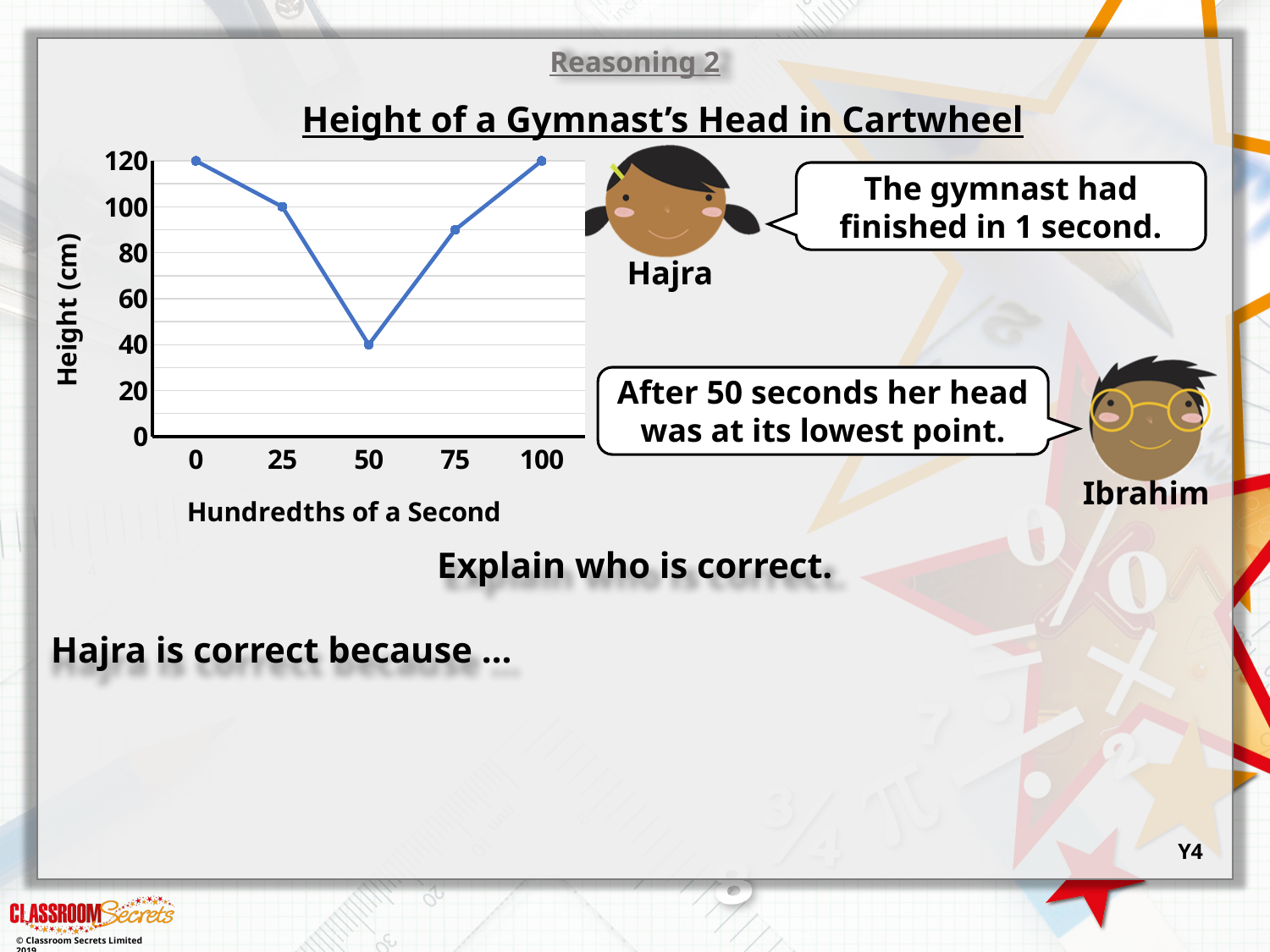
Does the height rise or fall between 0 and 50 hundredths of a second? fall What is the height of the gymnast's head at 0 hundredths of a second? 120 Which time has the greater height: 25 or 75 hundredths of a second? 25 At which time (in hundredths of a second) is the height of the gymnast's head lowest? 50 What is the height of the gymnast's head at 25 hundredths of a second? 100 Is the height at 75 hundredths of a second greater or less than 80? greater What kind of chart is shown on the slide? line chart How many data points are plotted on the line? 5 What is the height of the gymnast's head at 50 hundredths of a second? 40 What is the label on the horizontal axis? Hundredths of a Second What is the difference in height between 0 and 50 hundredths of a second? 80 What is the label on the vertical axis? Height (cm)